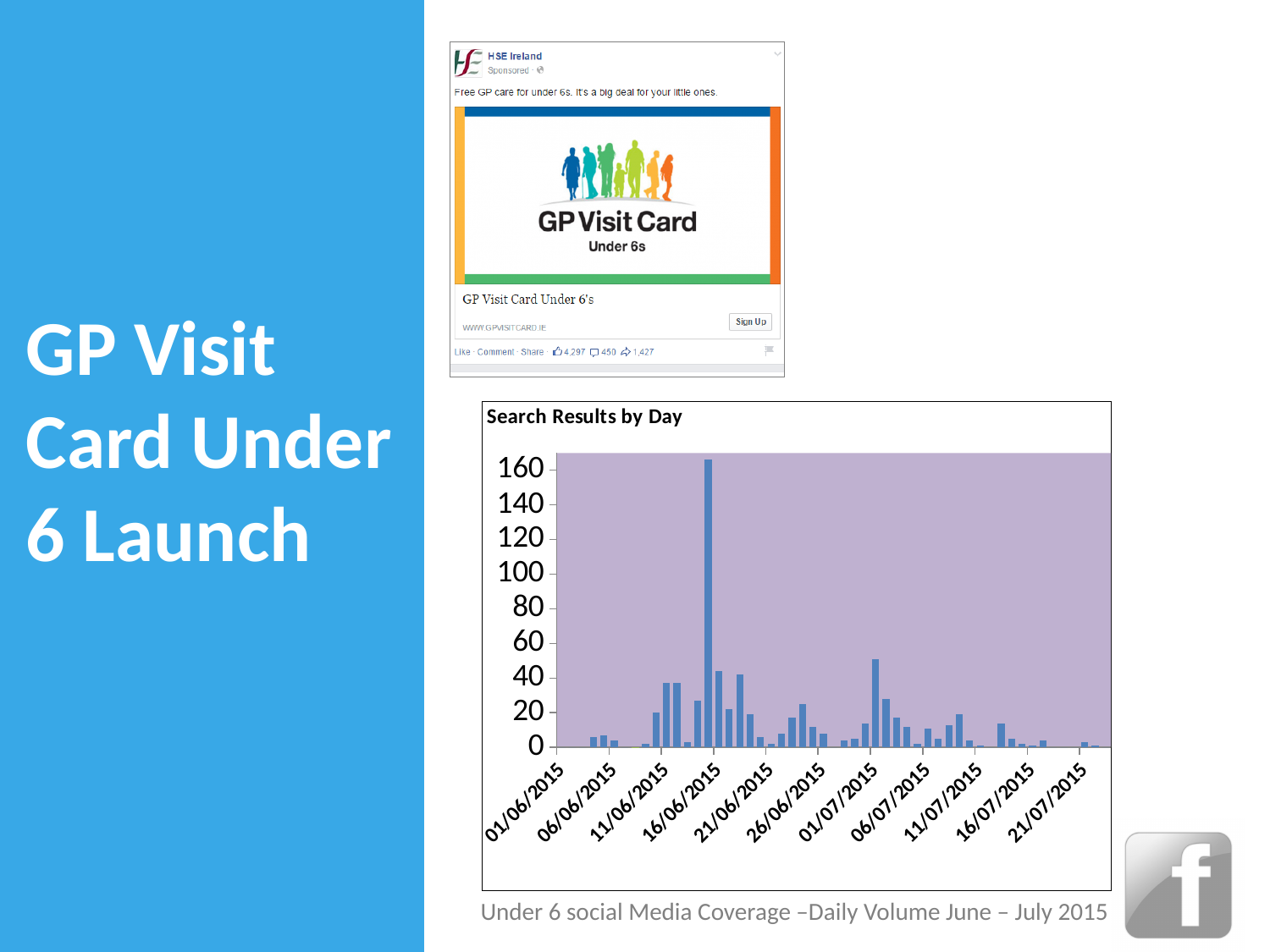
What is the last date label on the x axis of the 'Search Results by Day' chart? 21/07/2015 How many data series are plotted in the 'Search Results by Day' chart? 1 In the 'Search Results by Day' chart, is the value for 06/06/2015 greater or less than 20? less How many date labels are shown on the x axis of the 'Search Results by Day' chart? 11 In the 'Search Results by Day' chart, do the values generally rise or fall from mid-June to late July? fall What is the title of the chart on the slide? Search Results by Day What is the first date label on the x axis of the 'Search Results by Day' chart? 01/06/2015 What kind of chart is 'Search Results by Day'? bar chart What is the highest value shown on the y axis of the 'Search Results by Day' chart? 160 In the 'Search Results by Day' chart, is the value for 01/06/2015 greater or less than 20? less In the 'Search Results by Day' chart, is the tallest bar greater or less than 140? greater